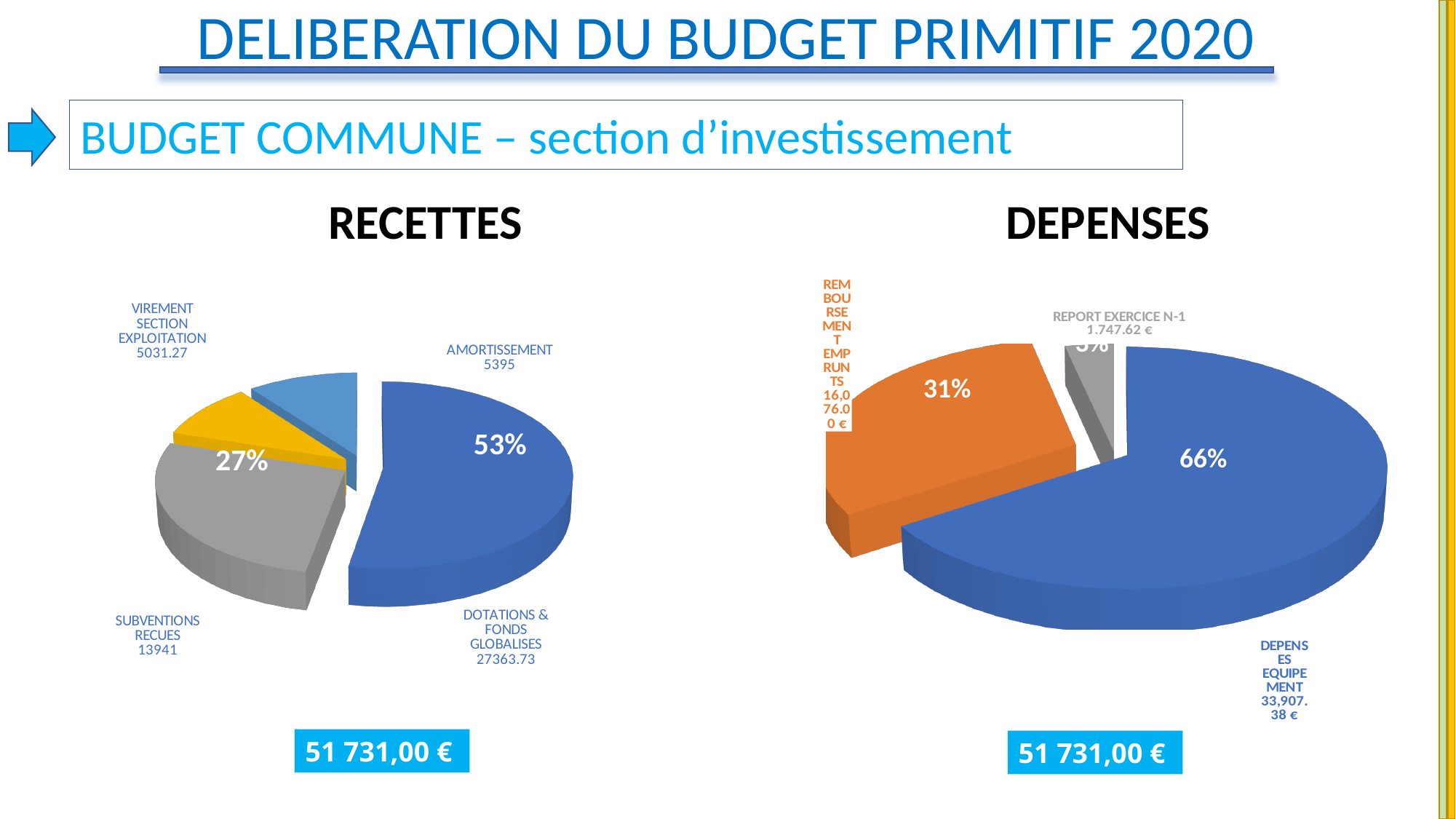
In the DEPENSES chart, what is the value for DEPENSES EQUIPEMENT? 33,907.38 € In the RECETTES chart, which category has the largest slice? DOTATIONS & FONDS GLOBALISES In the RECETTES chart, what is the value for DOTATIONS & FONDS GLOBALISES? 27363.73 In the RECETTES chart, what is the value for SUBVENTIONS RECUES? 13941 In the RECETTES chart, which category has the smallest value? VIREMENT SECTION EXPLOITATION In the RECETTES chart, what is the value for AMORTISSEMENT? 5395 In the DEPENSES chart, what percentage share does DEPENSES EQUIPEMENT represent? 66% In the DEPENSES chart, what is the value for REMBOURSEMENT EMPRUNTS? 16,076.00 € In the RECETTES chart, what percentage share does SUBVENTIONS RECUES represent? 27% In the DEPENSES chart, which is larger: REMBOURSEMENT EMPRUNTS or REPORT EXERCICE N-1? REMBOURSEMENT EMPRUNTS What type of chart is used for DEPENSES? Pie chart How many slices does the RECETTES pie chart have? 4